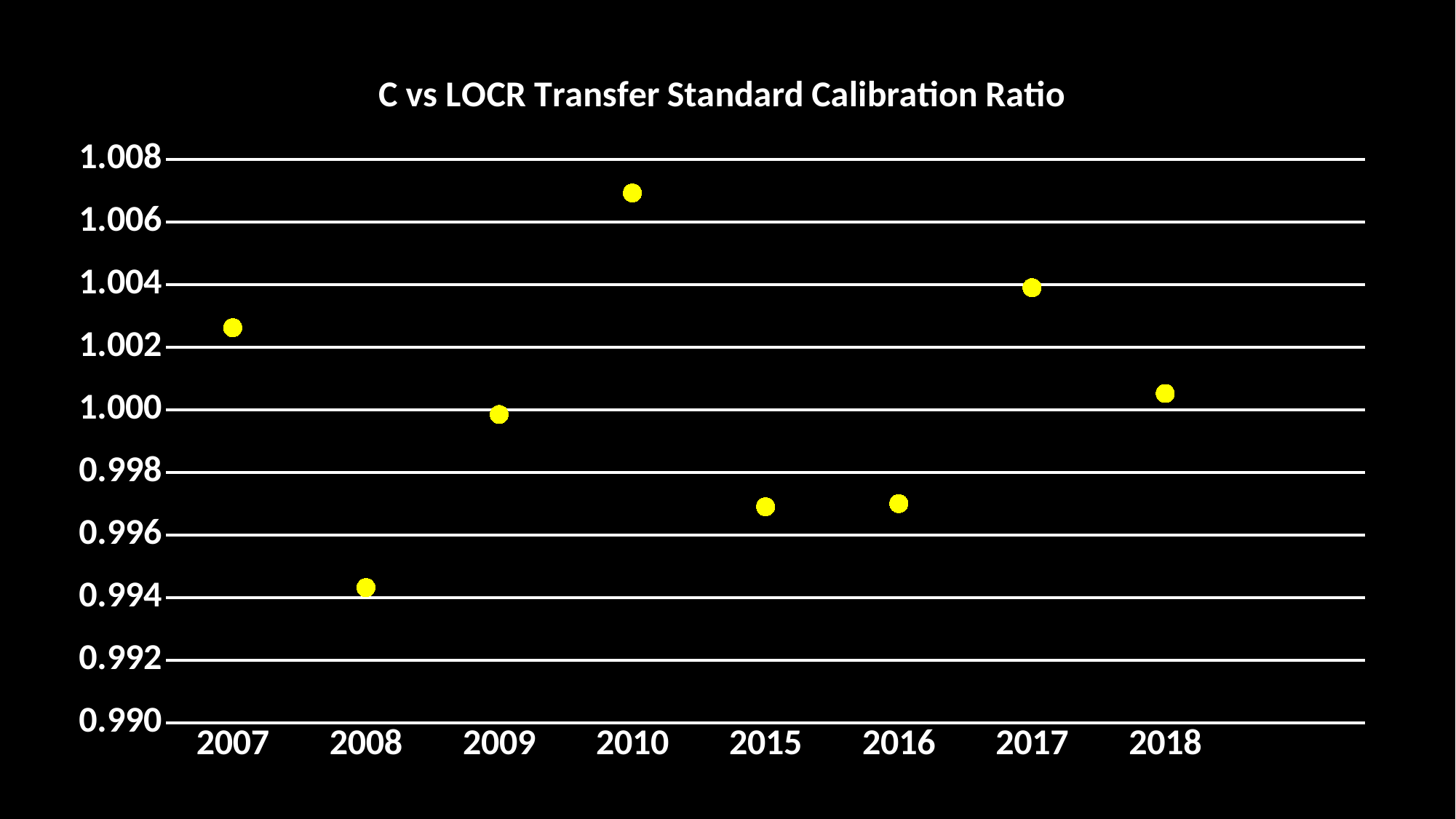
Is the value for 2015 greater or less than 0.998? less What kind of chart is shown on the slide? scatter chart Which year has the highest calibration ratio? 2010 Is the value for 2007 greater or less than 1.002? greater Is the value for 2010 greater or less than 1.006? greater What is the title of the chart? C vs LOCR Transfer Standard Calibration Ratio What colour are the plotted data points? yellow Which is larger, the value for 2007 or the value for 2008? 2007 Which is larger, the value for 2010 or the value for 2017? 2010 How many data points are plotted on the chart? 8 Which year has the lowest calibration ratio? 2008